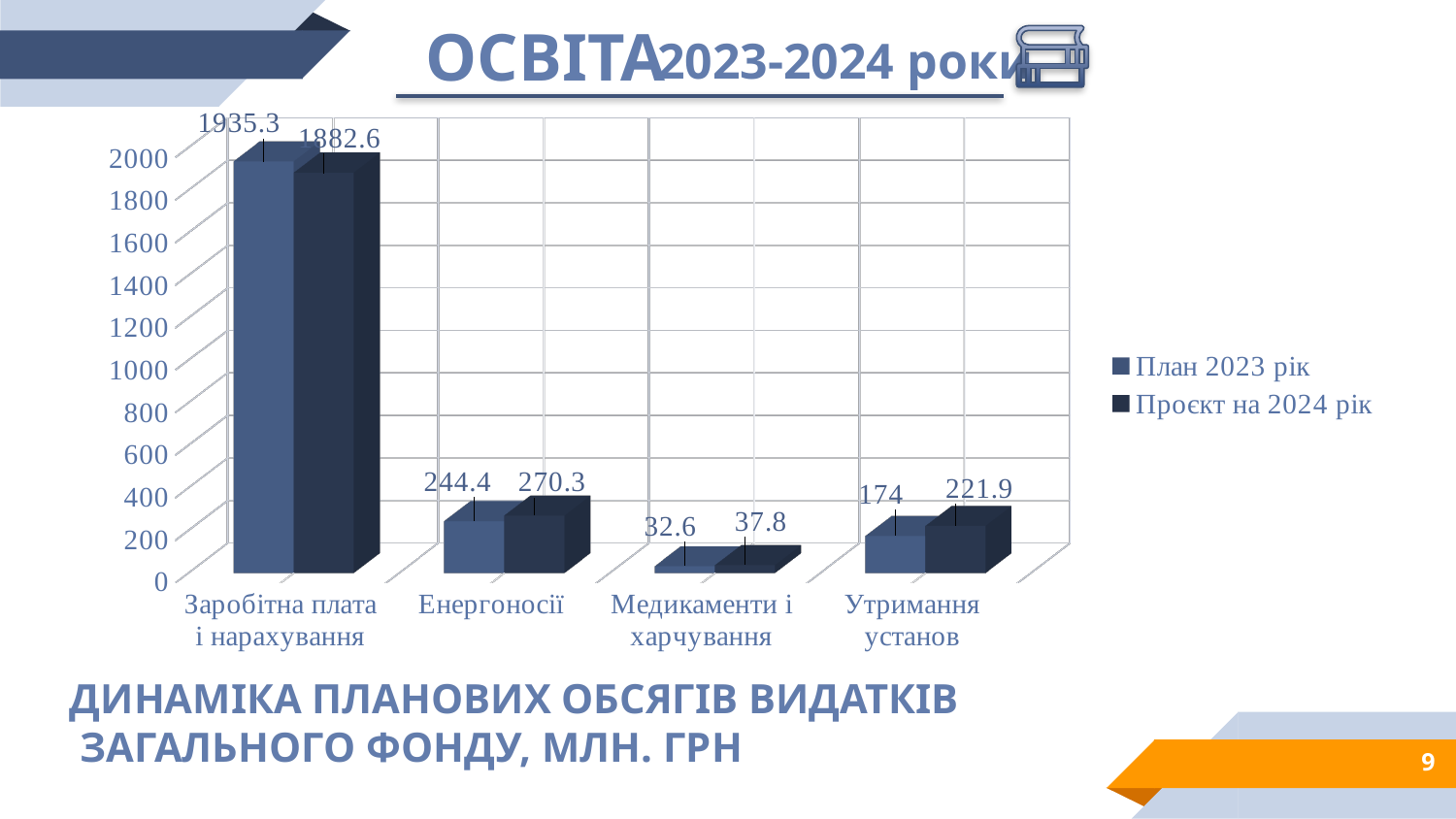
Which category has the highest value for "Проєкт на 2024 рік"? Заробітна плата і нарахування What is the value of "План 2023 рік" for "Утримання установ"? 174 What is the value of "План 2023 рік" for "Заробітна плата і нарахування"? 1935.3 Which category has the lowest value for "План 2023 рік"? Медикаменти і харчування How many series does the legend list? 2 What is the value of "Проєкт на 2024 рік" for "Енергоносії"? 270.3 How many categories are shown on the x axis? 4 What is the value of "Проєкт на 2024 рік" for "Медикаменти і харчування"? 37.8 What kind of chart is shown on the slide? Bar chart What is the second entry in the chart legend? Проєкт на 2024 рік What is the difference between "Проєкт на 2024 рік" and "План 2023 рік" for "Утримання установ"? 47.9 For "Заробітна плата і нарахування", which is larger: "План 2023 рік" or "Проєкт на 2024 рік"? План 2023 рік